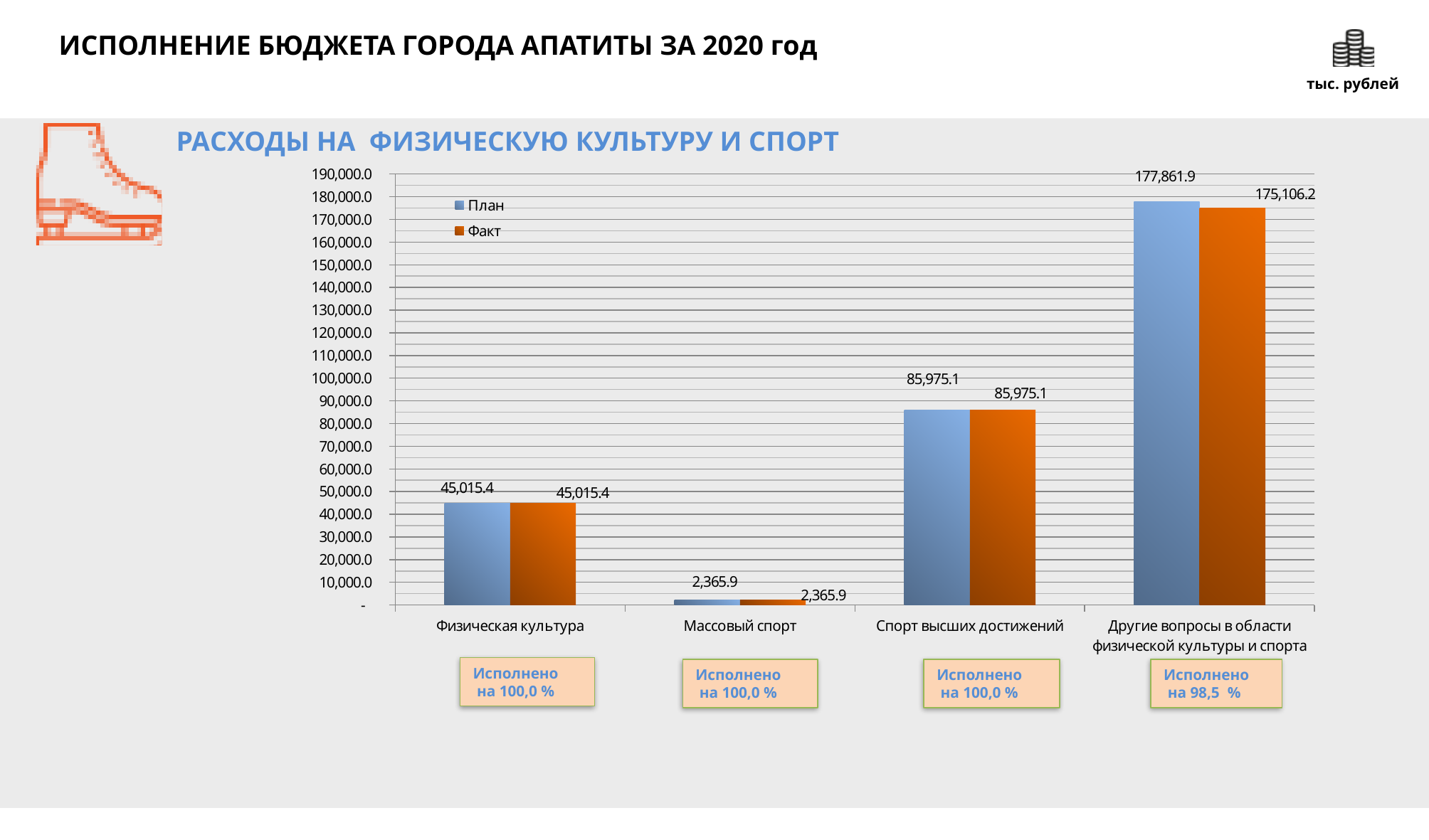
What is the План value for Массовый спорт? 2,365.9 How many categories are shown on the x axis? 4 Which is larger for Другие вопросы в области физической культуры и спорта: the План value or the Факт value? План Which category has the lowest Факт value? Массовый спорт What is the План value for Спорт высших достижений? 85,975.1 What kind of chart is shown on the slide? Bar chart What is the difference between the План and Факт values for Другие вопросы в области физической культуры и спорта? 2,755.7 What is the Факт value for Физическая культура? 45,015.4 What is the Факт value for Другие вопросы в области физической культуры и спорта? 175,106.2 What are the two series named in the legend? План and Факт Which category has the highest План value? Другие вопросы в области физической культуры и спорта How many series does the legend list? 2